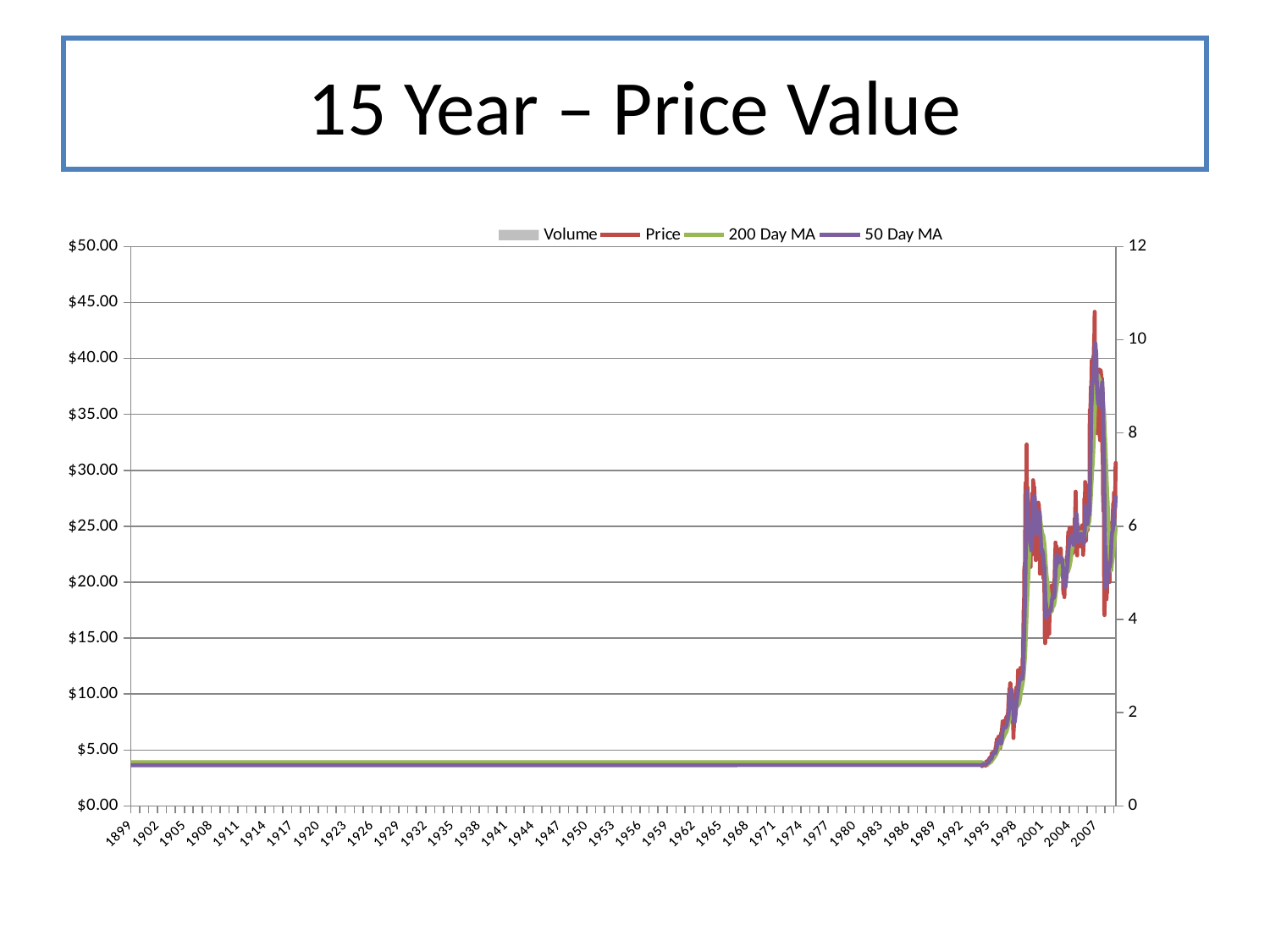
What is the title of the slide containing the chart? 15 Year – Price Value How many series does the chart legend list? 4 Is the peak Price value reached around 2007 greater or less than $40.00? greater What is the highest value shown on the left vertical axis? $50.00 What kind of chart is shown on the slide? line chart What is the last year label on the horizontal axis? 2007 What is the highest value shown on the right vertical axis? 12 Which series are listed in the chart legend? Volume, Price, 200 Day MA, 50 Day MA Is the Price value in 1950 greater or less than $5.00? less Overall, does the Price series rise or fall from 1899 to 2007? rise Is the Price value in 1980 greater or less than $10.00? less What is the first year label on the horizontal axis? 1899